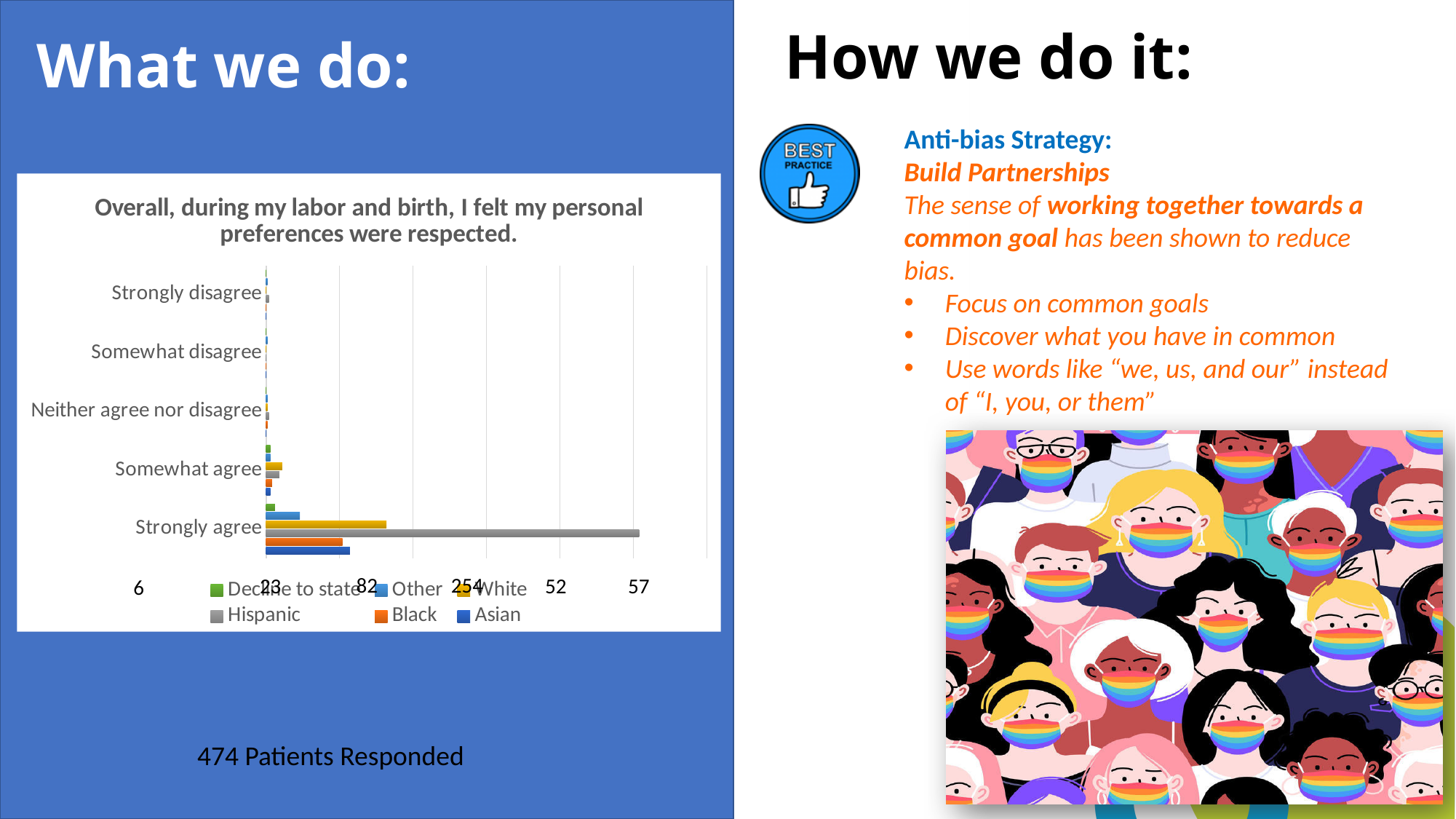
Which series is shown in orange in the chart's legend? Black In the Strongly agree category, is the bar for Hispanic or for Black longer? Hispanic What is the title of the chart? Overall, during my labor and birth, I felt my personal preferences were respected. What kind of chart is shown on the slide? bar chart Which series has the longest bar anywhere in the chart? Hispanic In the Strongly agree category, is the bar for White or for Other longer? White Which response category has the longest bars in the chart? Strongly agree In the Strongly agree category, is the bar for Asian or for Decline to state longer? Asian How many response categories are shown on the vertical axis of the chart? 5 How many series does the chart's legend list? 6 Within the Strongly agree category, which series has the longest bar? Hispanic